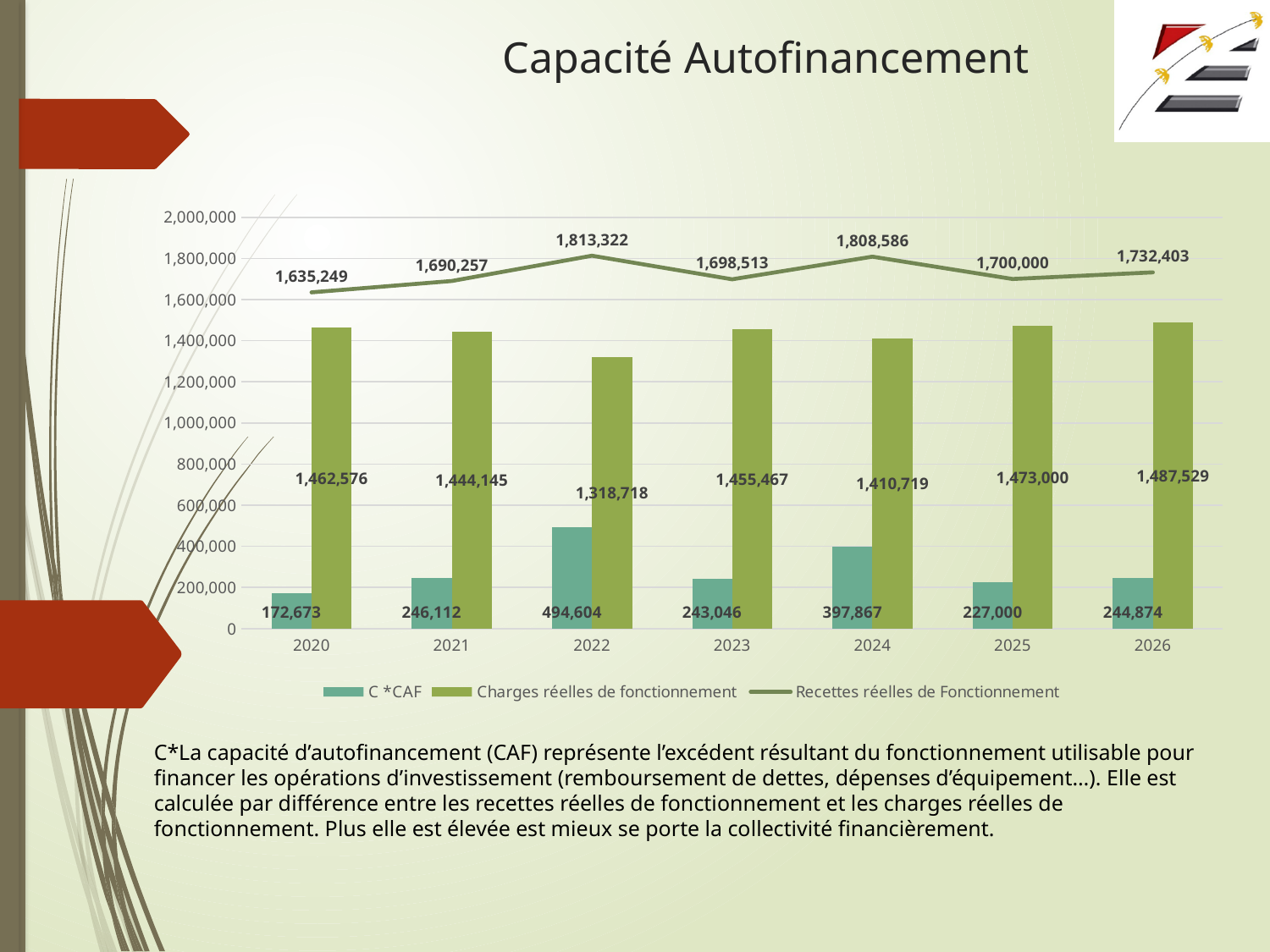
In which year is C *CAF the highest? 2022 What is the value of Charges réelles de fonctionnement for 2021? 1,444,145 How many years are shown on the x axis? 7 Which is larger, C *CAF in 2024 or C *CAF in 2025? 2024 How many series does the legend list? 3 In which year are Charges réelles de fonctionnement the lowest? 2022 What is the difference between Recettes réelles de Fonctionnement and Charges réelles de fonctionnement in 2022? 494,604 What is the value of Recettes réelles de Fonctionnement for 2024? 1,808,586 What is the value of C *CAF for 2022? 494,604 In which year is C *CAF the lowest? 2020 What is the difference between C *CAF in 2022 and C *CAF in 2020? 321,931 In which year are Recettes réelles de Fonctionnement the highest? 2022